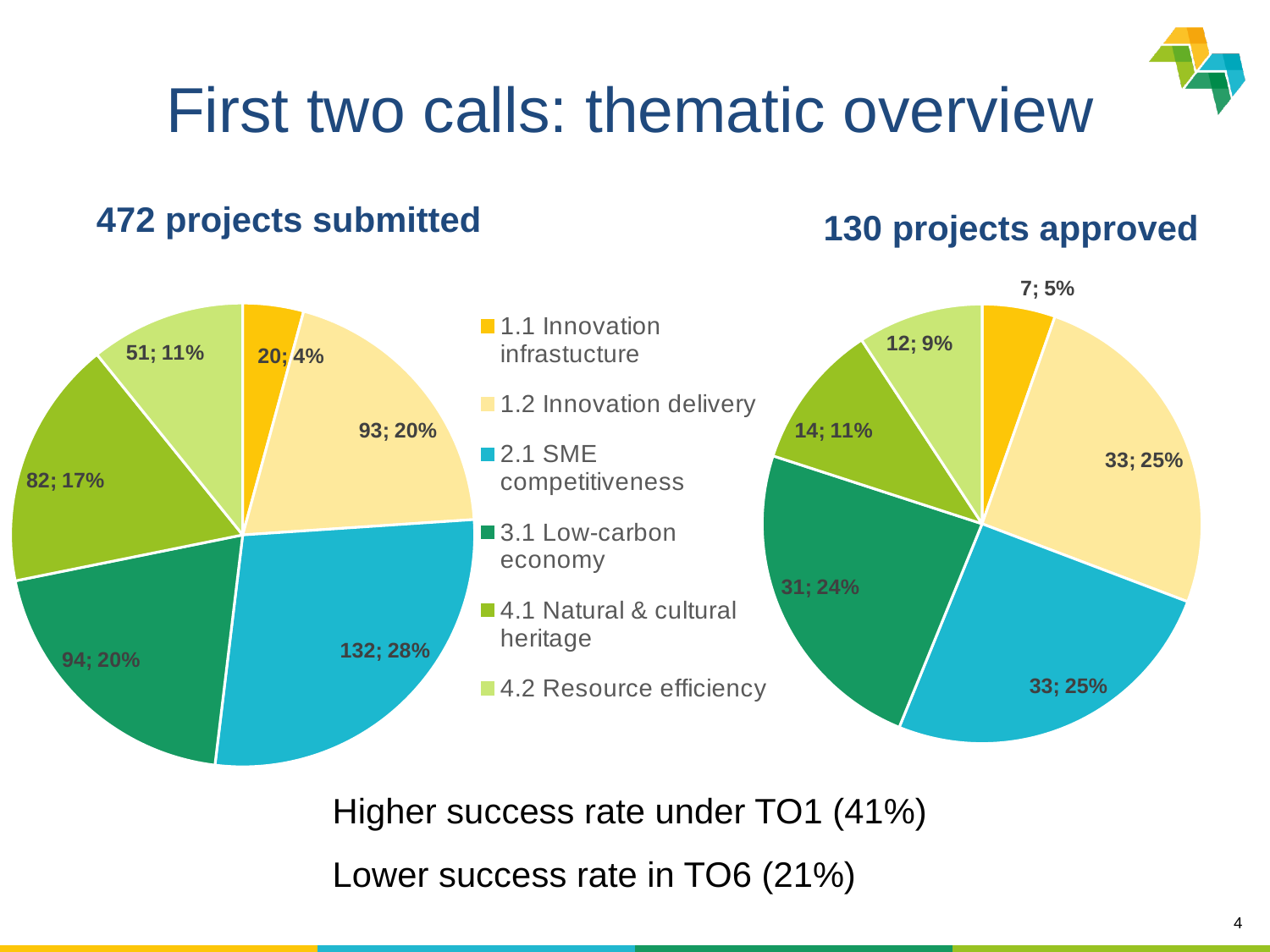
What kind of chart is the '130 projects approved' chart? Pie chart How many entries does the legend between the two charts list? 6 In the '130 projects approved' chart, how many projects were approved under 3.1 Low-carbon economy? 31 In the '472 projects submitted' chart, what share of submitted projects falls under 4.2 Resource efficiency? 11% In the '472 projects submitted' chart, which category has the largest number of submitted projects? 2.1 SME competitiveness In the '472 projects submitted' chart, how many projects were submitted under 2.1 SME competitiveness? 132 In the '472 projects submitted' chart, what is the difference between the number of projects submitted under 3.1 Low-carbon economy and under 4.1 Natural & cultural heritage? 12 In the '130 projects approved' chart, which category has the smallest number of approved projects? 1.1 Innovation infrastucture In the '130 projects approved' chart, which has more approved projects: 4.1 Natural & cultural heritage or 4.2 Resource efficiency? 4.1 Natural & cultural heritage In the '130 projects approved' chart, what share of approved projects falls under 1.2 Innovation delivery? 25% How many categories does the '472 projects submitted' chart show? 6 Which colour represents 2.1 SME competitiveness in the charts? Cyan (light blue)